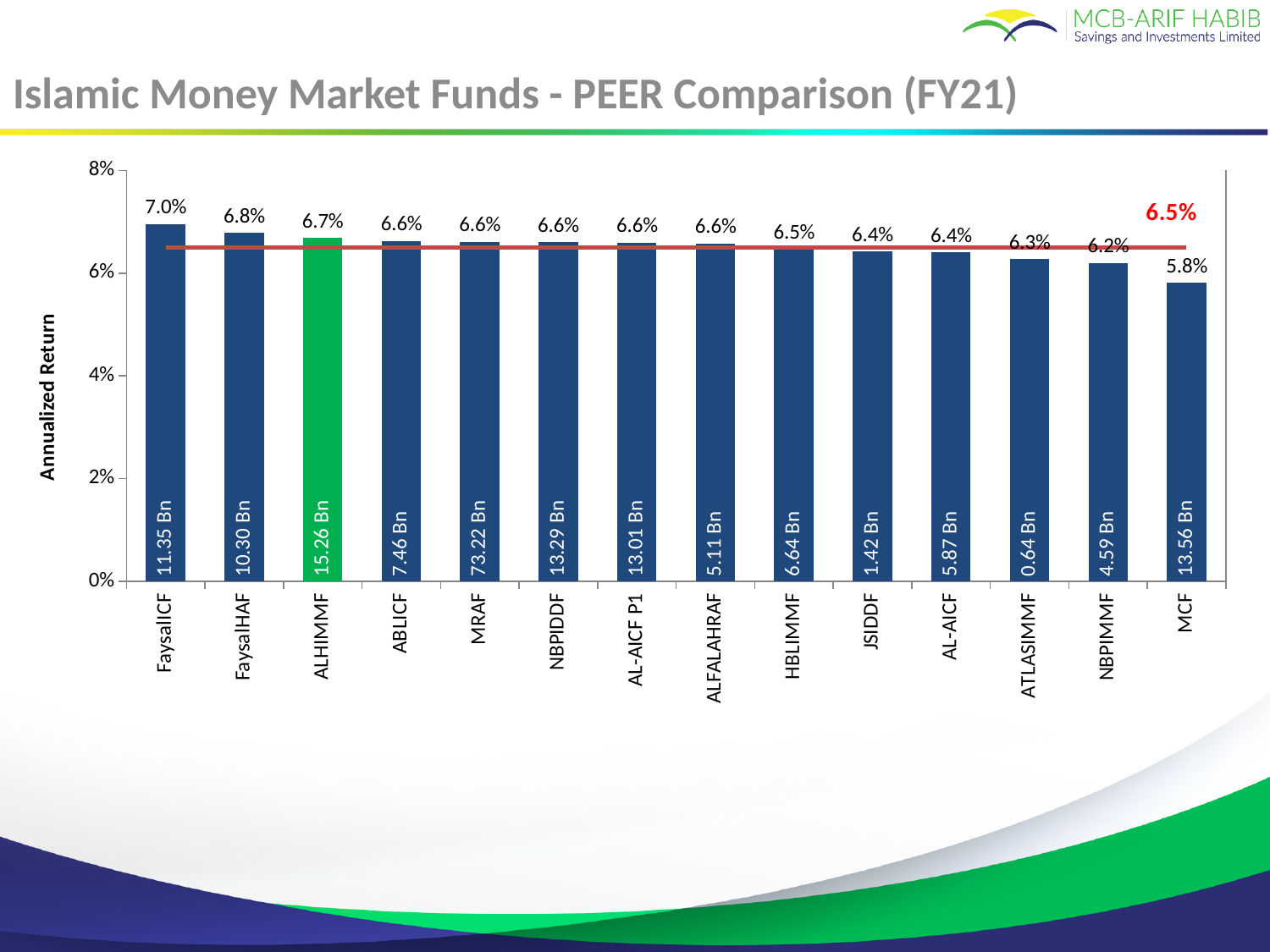
What fund size is printed inside the ATLASIMMF bar? 0.64 Bn Which fund has the highest annualized return? FaysalICF Is the annualized return for JSIDDF greater or less than 4%? greater What fund size is printed inside the MRAF bar? 73.22 Bn Which has a higher annualized return, FaysalHAF or NBPIMMF? FaysalHAF How many funds are shown on the chart? 14 What kind of chart is shown on the slide? Bar chart What is the annualized return for MCF? 5.8% Which fund has the lowest annualized return? MCF What value is labelled on the red horizontal line across the chart? 6.5% What is the difference in annualized return between FaysalICF and MCF? 1.2% What is the annualized return for ALHIMMF? 6.7%